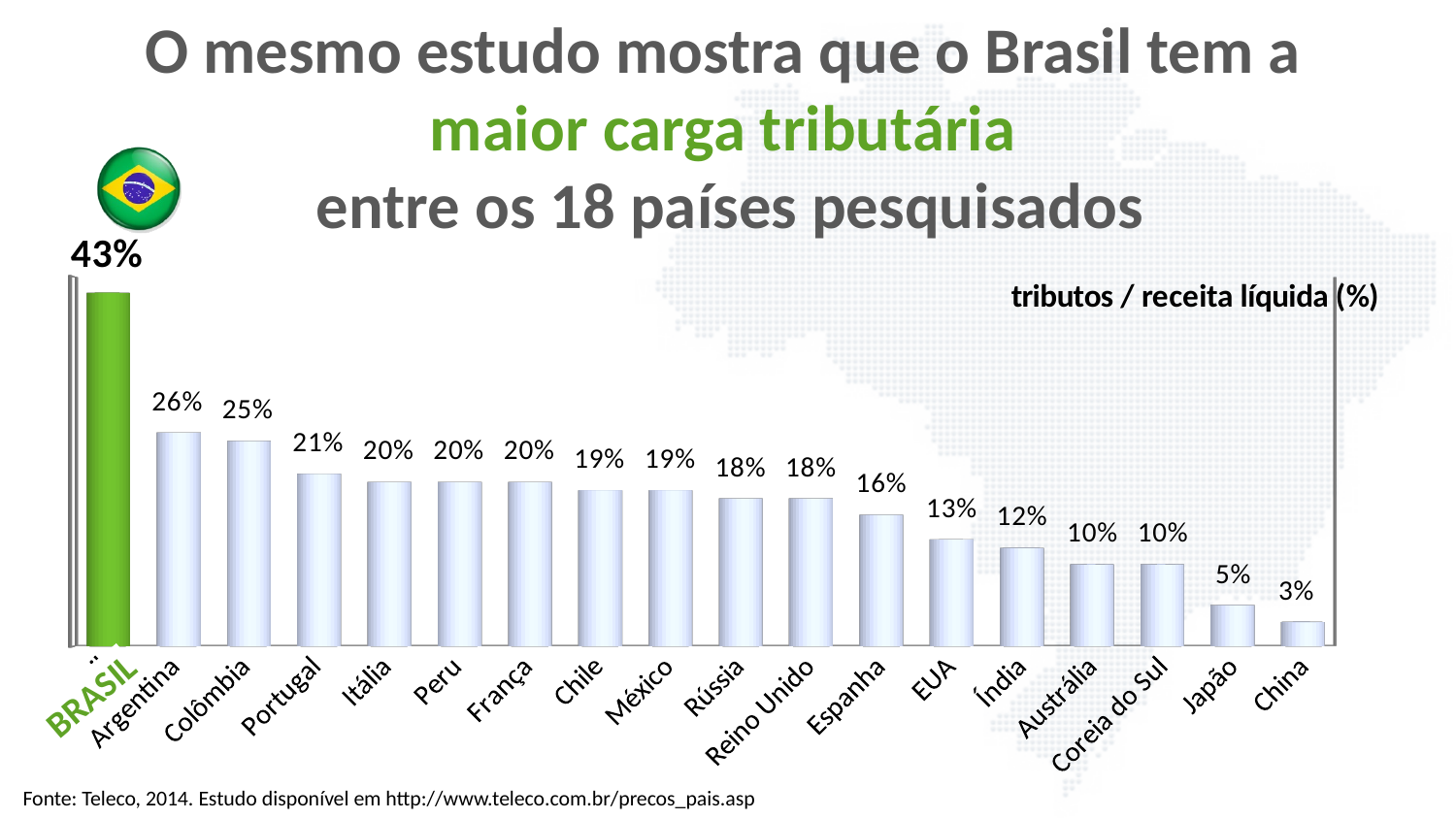
What is the value shown for Argentina? 26% Which country has the lowest value in the chart? China What is the value shown for Espanha? 16% Which country has the highest value in the chart? Brasil Which has a higher value, Colômbia or Portugal? Colômbia What label is shown at the top right of the chart describing the measure plotted? tributos / receita líquida (%) What is the difference between the values for Brasil and Argentina? 17% What is the value shown for Japão? 5% What is the value shown for Brasil? 43% What type of chart is shown on the slide? Bar chart How many countries are shown in the chart? 18 What is the difference between the values for EUA and Índia? 1%